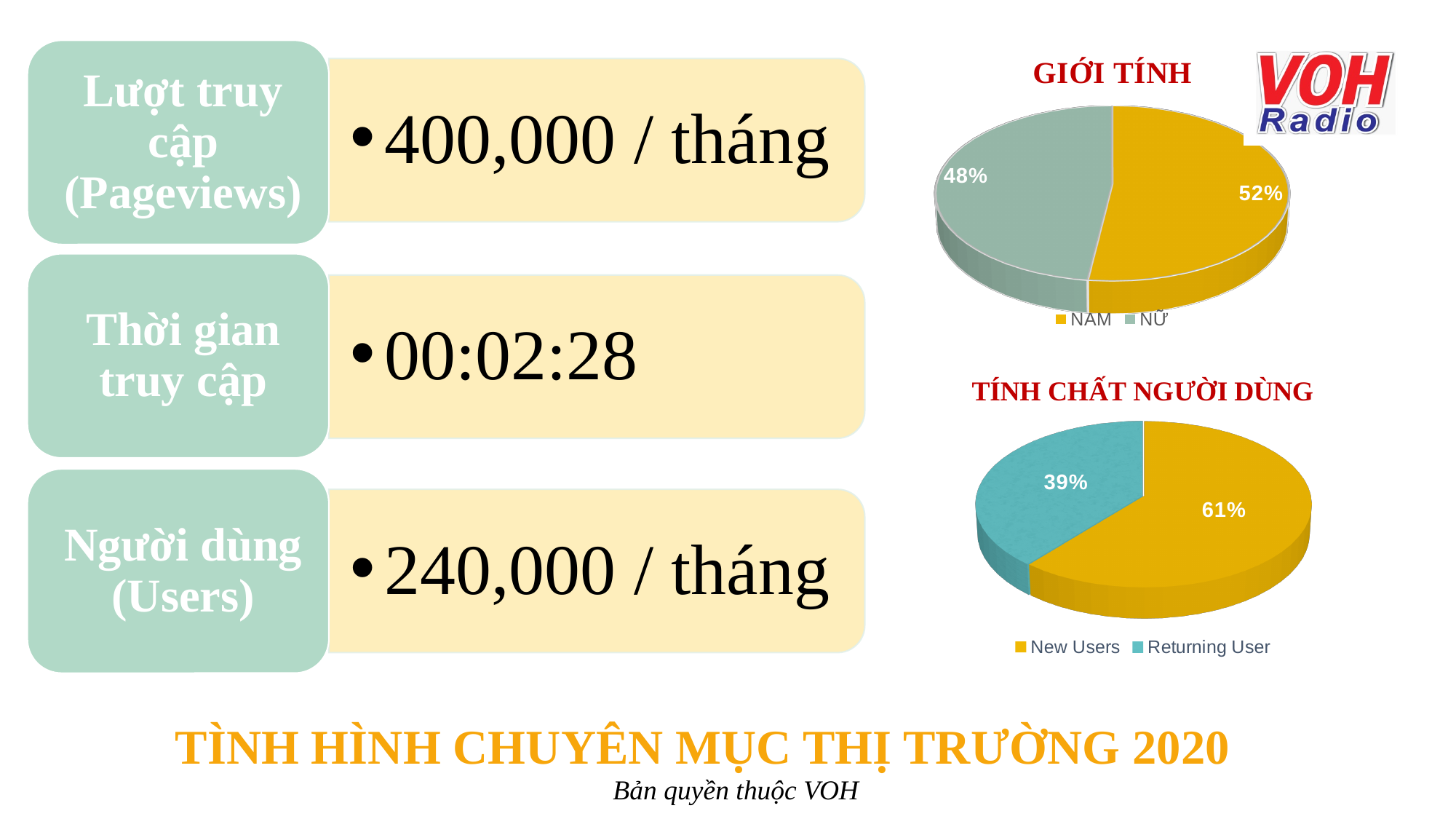
In the GIỚI TÍNH chart, what is the difference in percentage points between NAM and NỮ? 4 In the TÍNH CHẤT NGƯỜI DÙNG chart, what percentage is shown for Returning User? 39% In the TÍNH CHẤT NGƯỜI DÙNG chart, what is the difference in percentage points between New Users and Returning User? 22 In the TÍNH CHẤT NGƯỜI DÙNG chart, what percentage is shown for New Users? 61% In the GIỚI TÍNH chart, how many slices does the pie have? 2 In the GIỚI TÍNH chart, what percentage is shown for NAM? 52% In the GIỚI TÍNH chart, what percentage is shown for NỮ? 48% What type of chart is the GIỚI TÍNH chart? Pie chart In the TÍNH CHẤT NGƯỜI DÙNG chart, what colour is the New Users slice? Yellow In the TÍNH CHẤT NGƯỜI DÙNG chart, is the share for New Users larger or smaller than the share for Returning User? Larger In the GIỚI TÍNH chart, which category has the larger share? NAM In the TÍNH CHẤT NGƯỜI DÙNG chart, which category has the smaller share? Returning User